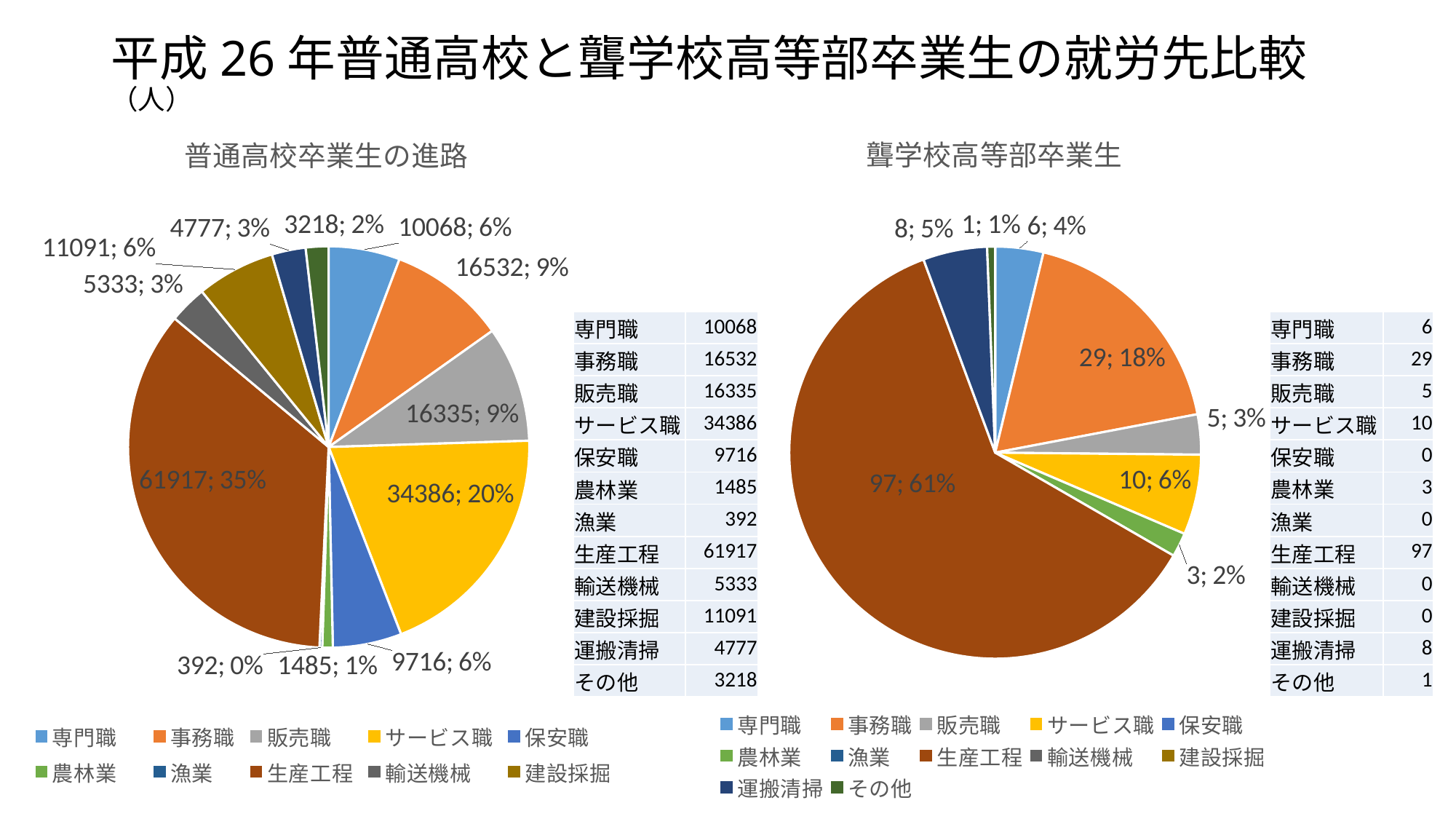
In the right chart (聾学校高等部卒業生), what is the value for 運搬清掃? 8 In the left chart (普通高校卒業生の進路), what is the value for 生産工程? 61917 In the left chart (普通高校卒業生の進路), which category has the largest value? 生産工程 How many entries does the legend of the right chart (聾学校高等部卒業生) list? 12 What kind of chart is used on this slide? Pie chart In the left chart (普通高校卒業生の進路), what is the difference between 事務職 and 販売職? 197 In the right chart (聾学校高等部卒業生), what share of the pie does 生産工程 represent? 61% In the left chart (普通高校卒業生の進路), what share of the pie does 生産工程 represent? 35% In the left chart (普通高校卒業生の進路), which is larger, サービス職 or 保安職? サービス職 In the right chart (聾学校高等部卒業生), what is the difference between 生産工程 and 事務職? 68 In the left chart (普通高校卒業生の進路), which category has the smallest value? 漁業 In the right chart (聾学校高等部卒業生), what is the value for 事務職? 29